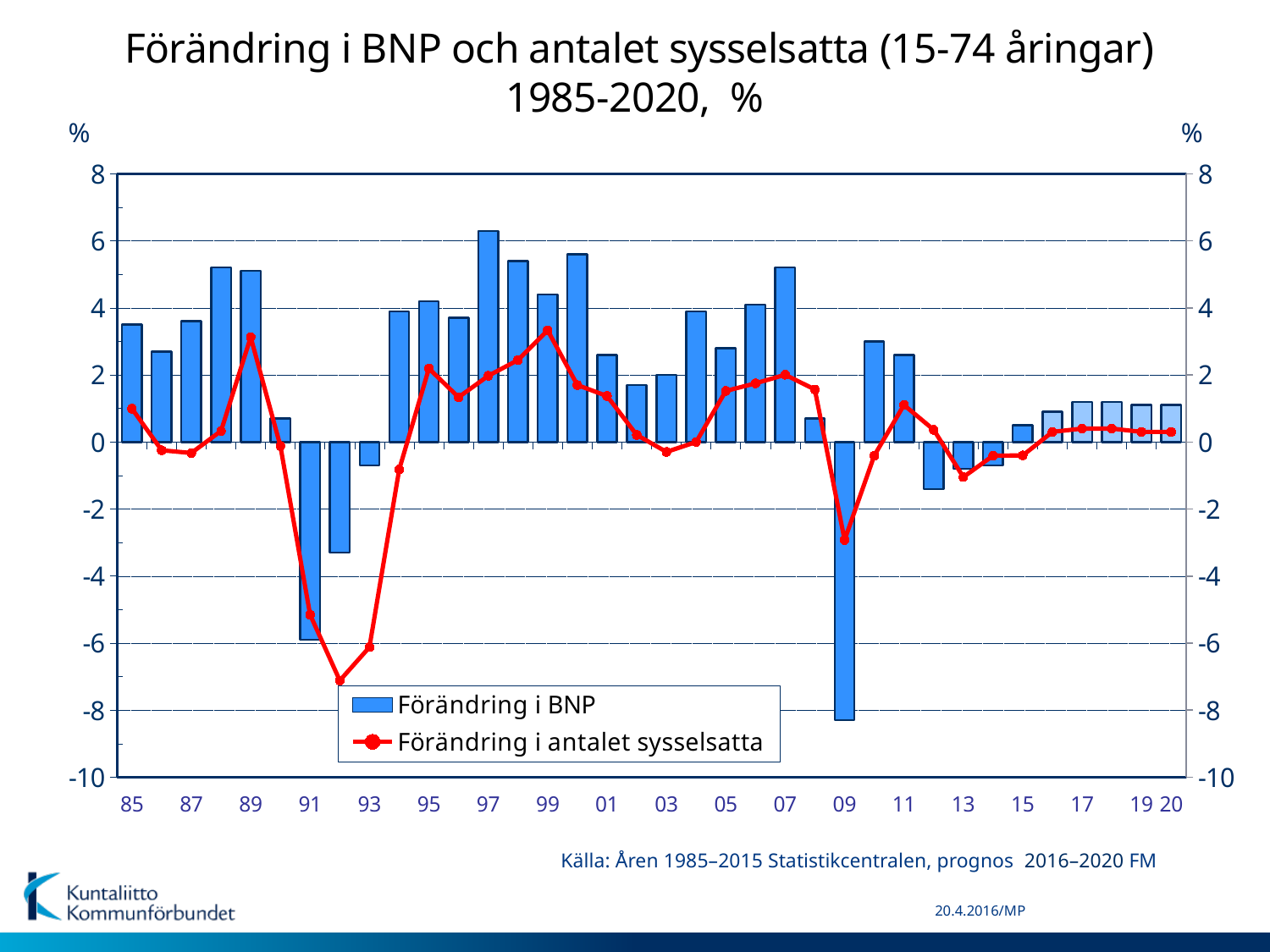
Is the Förändring i antalet sysselsatta value for 1992 greater or less than -6? less Is the Förändring i BNP value for 2009 greater or less than -6? less How many series does the legend list? 2 What kind of chart is shown on the slide? A bar chart combined with a line chart What are the two series named in the legend? Förändring i BNP and Förändring i antalet sysselsatta In which year is the Förändring i BNP bar the highest? 1997 Is the Förändring i BNP value for 1997 greater or less than 4? greater Which year has the larger Förändring i BNP value, 1988 or 1991? 1988 In which year does the Förändring i antalet sysselsatta line reach its lowest point? 1992 Which series is drawn as a red line with markers? Förändring i antalet sysselsatta In which year is the Förändring i BNP bar the lowest? 2009 How many years are covered on the x axis of the chart? 36